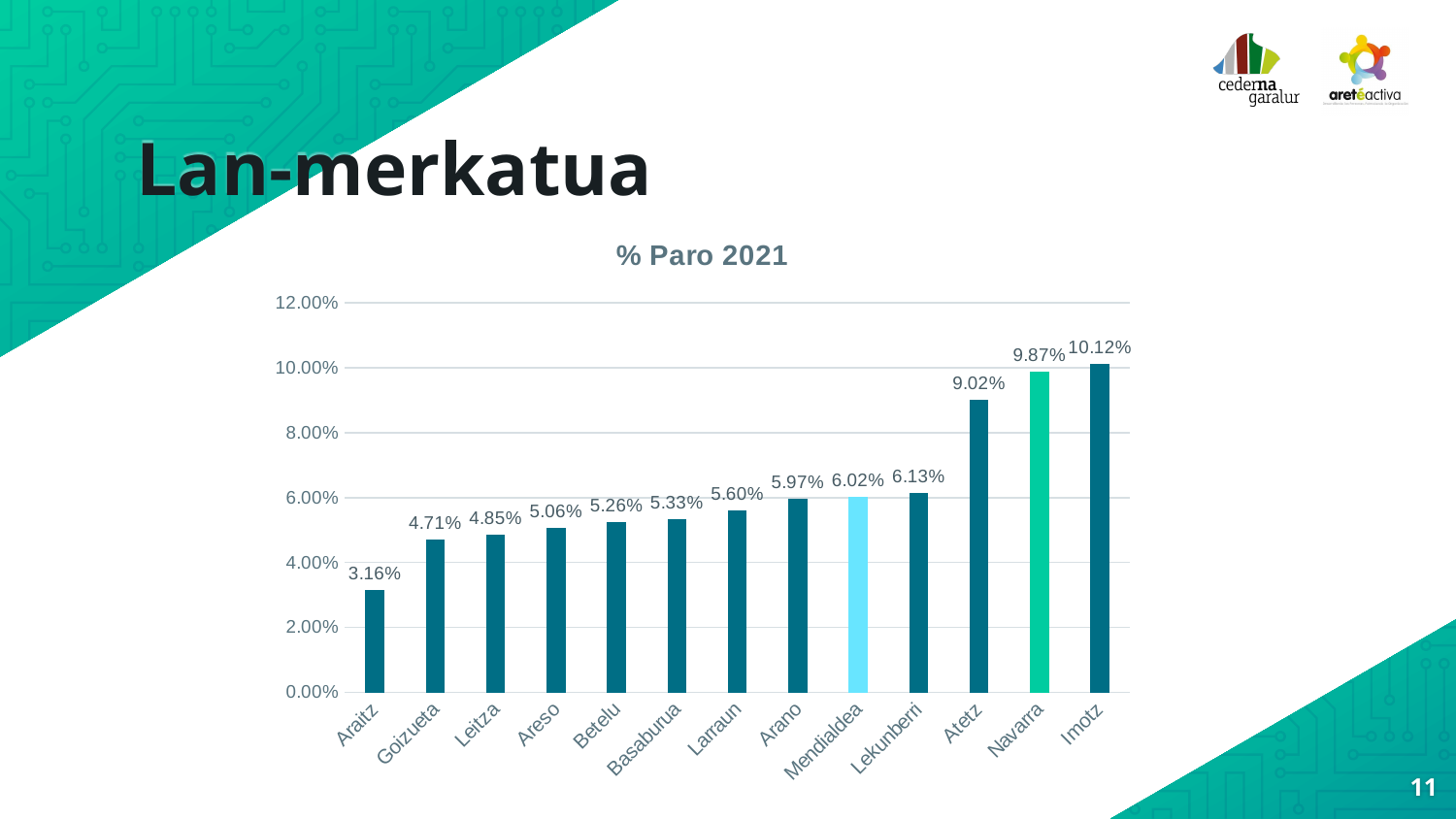
What is the value for Navarra? 9.87% How many categories are shown on the x axis? 13 Do the values generally rise or fall from left to right along the x axis? rise Is the value for Atetz greater or less than 8.00%? greater What is the value for Araitz? 3.16% Which is larger, the value for Lekunberri or the value for Larraun? Lekunberri What is the difference between the values for Imotz and Atetz? 1.10% Which category has the lowest value? Araitz Which category has the highest value? Imotz What is the value for Mendialdea? 6.02% What is the title of the chart? % Paro 2021 What type of chart is shown on the slide? bar chart